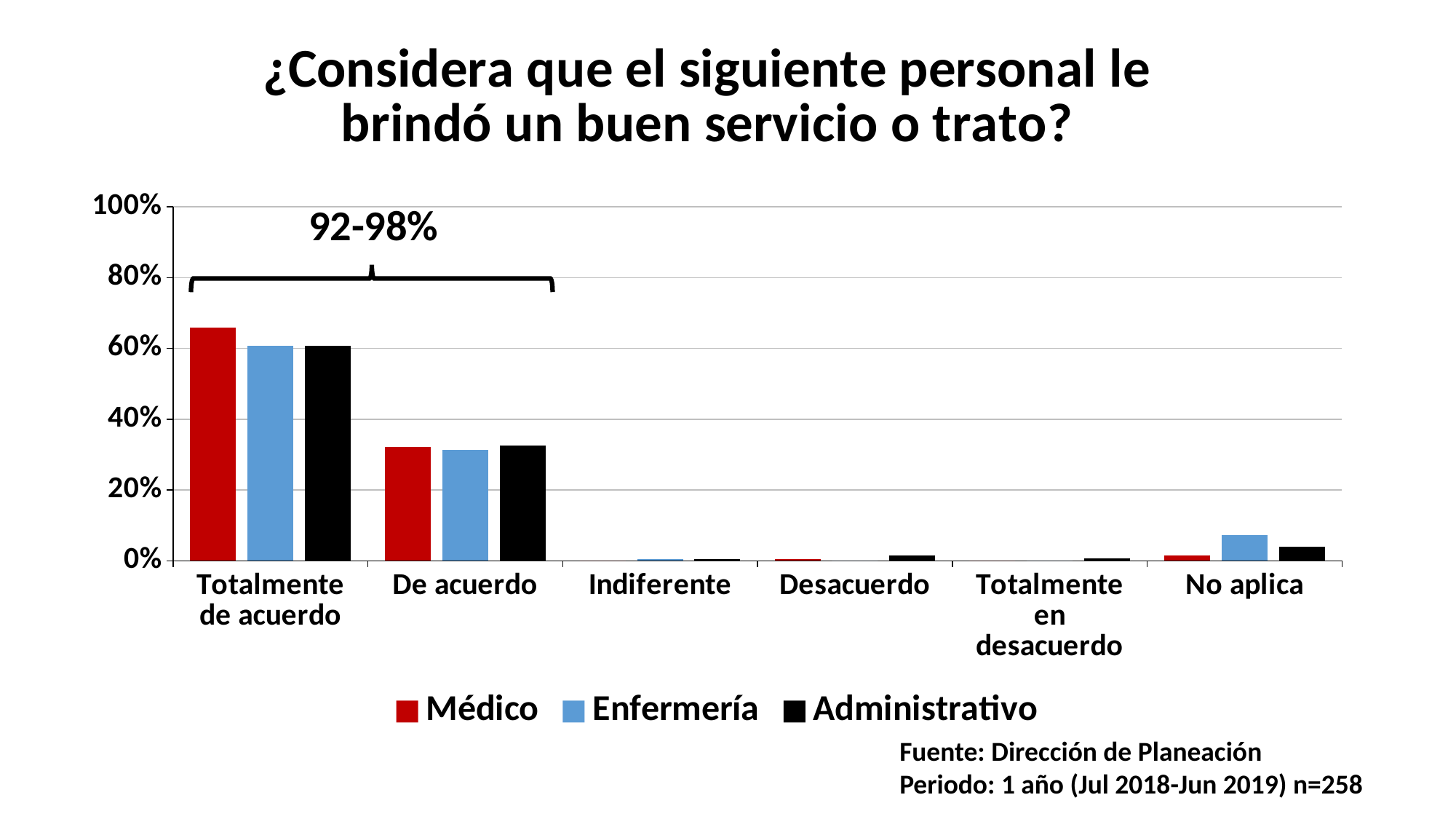
In the Totalmente de acuerdo category, which is larger: Médico or Enfermería? Médico How many response categories are shown on the x axis? 6 For the Médico series, which category has the highest value? Totalmente de acuerdo Is the Médico value for Totalmente de acuerdo greater or less than 60%? greater Is the Enfermería value for De acuerdo greater or less than 40%? less What range is written in the annotation above the first two categories? 92-98% In the No aplica category, which is larger: Enfermería or Administrativo? Enfermería Is the Administrativo value for Totalmente de acuerdo greater or less than 80%? less How many series does the legend list? 3 What kind of chart is shown on the slide? bar chart In the No aplica category, which series has the highest value? Enfermería For the Médico series, which is larger: Totalmente de acuerdo or De acuerdo? Totalmente de acuerdo